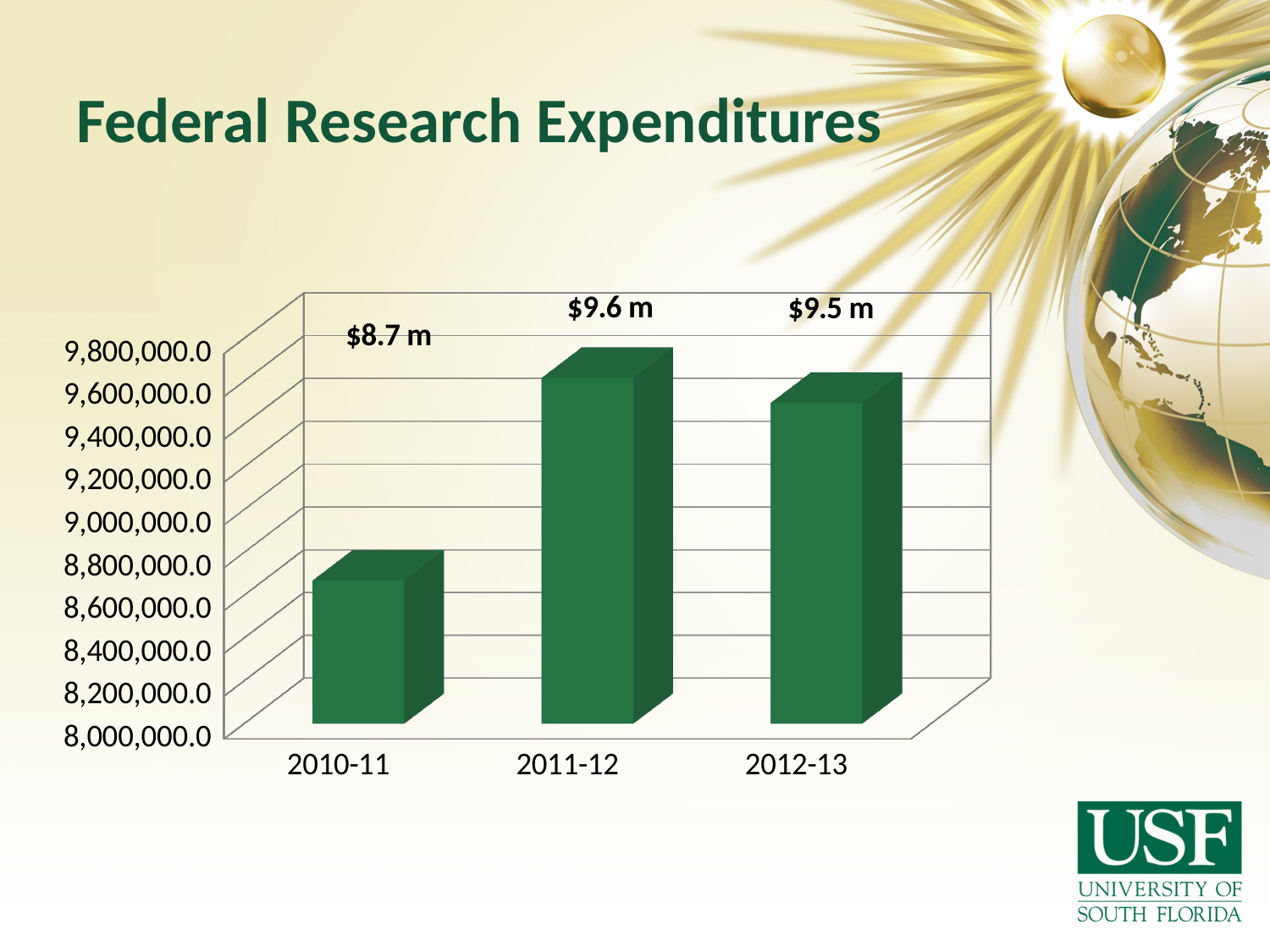
Which is larger, the value for 2011-12 or the value for 2012-13? 2011-12 What is the difference between the values for 2011-12 and 2010-11? $0.9 m Does the value rise or fall from 2010-11 to 2011-12? rise Which year has the highest federal research expenditures? 2011-12 What is the value for 2010-11? $8.7 m What is the value for 2012-13? $9.5 m How many years are shown on the chart? 3 What is the value for 2011-12? $9.6 m Is the value for 2010-11 greater or less than 9,000,000.0? less Which year has the lowest federal research expenditures? 2010-11 What is the title of the slide? Federal Research Expenditures What kind of chart is shown on the slide? bar chart